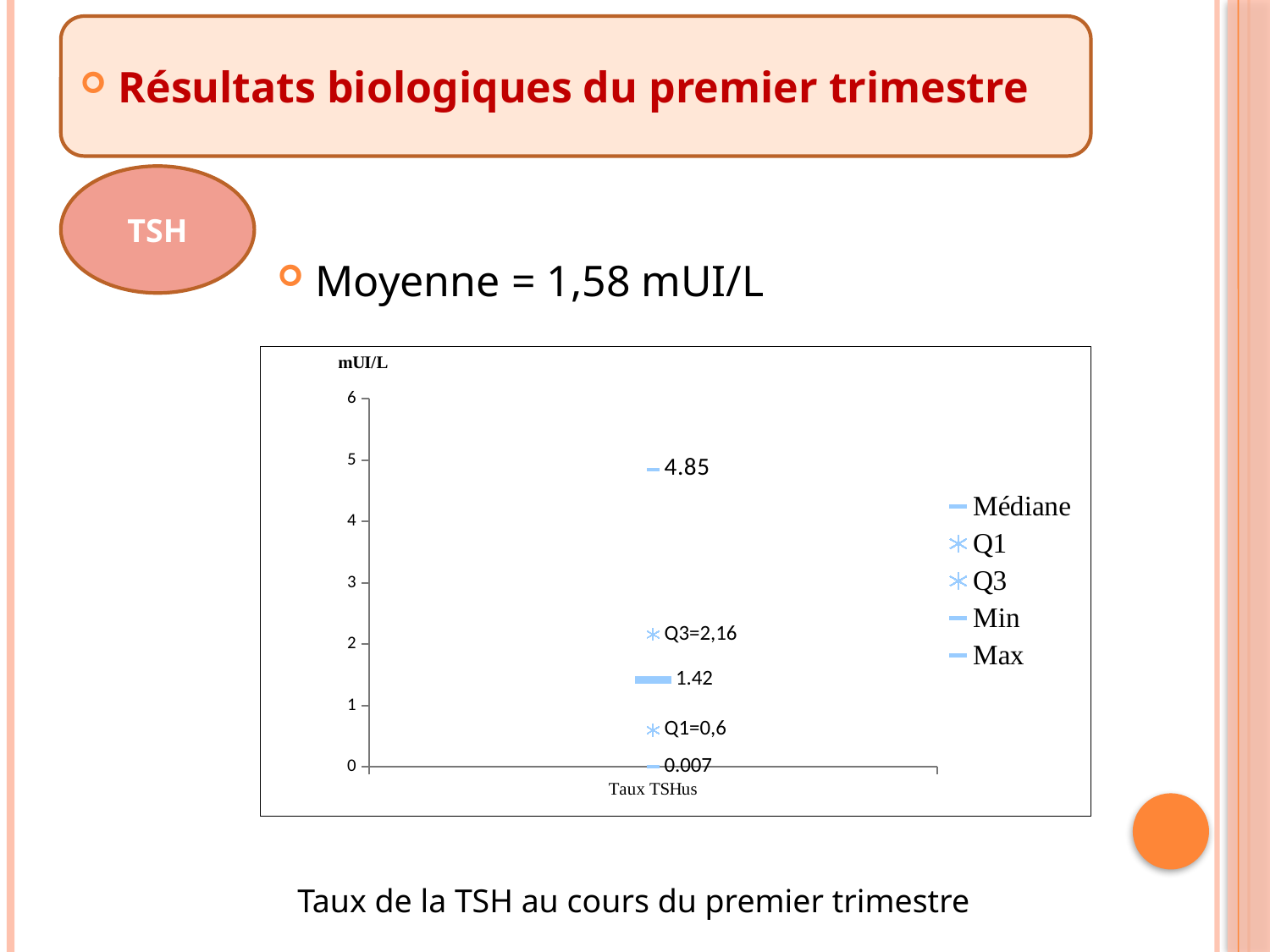
What is the Q3 value labelled on the chart? 2,16 Which series has the highest plotted value on the chart? Max What is the Max value shown for Taux TSHus? 4.85 What is the Min value shown for Taux TSHus? 0.007 What is the difference between Q3 and Q1? 1,56 Which is larger, the Q3 value or the Médiane value? Q3 What is the Médiane value shown for Taux TSHus? 1.42 Which series has the lowest plotted value on the chart? Min What is the Q1 value labelled on the chart? 0,6 What is the difference between the Max value and the Médiane value? 3.43 What unit is shown on the vertical axis of the chart? mUI/L How many series does the legend list? 5